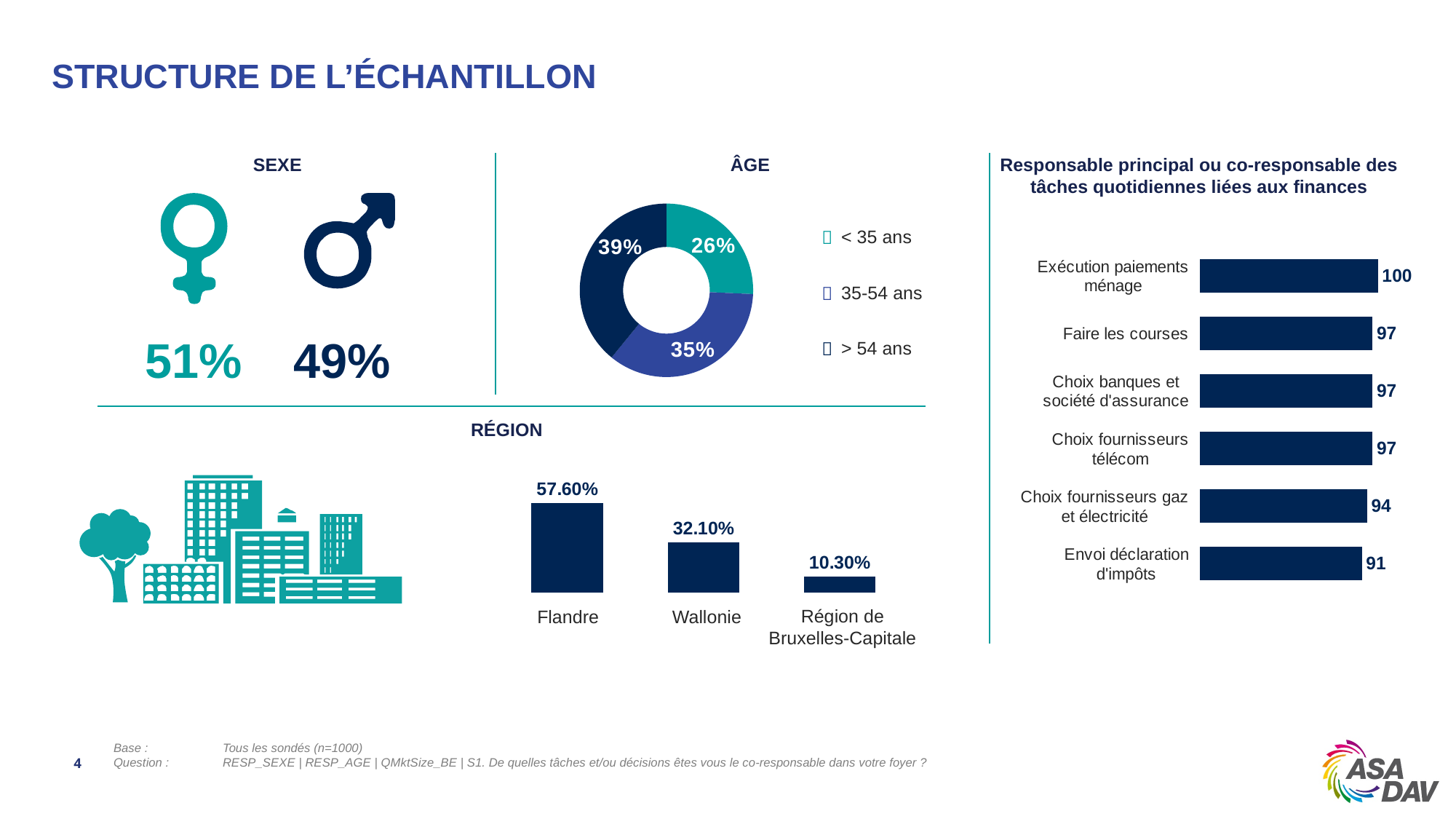
How many regions are shown in the RÉGION chart? 3 What kind of chart is the ÂGE chart? Donut chart In the 'Responsable principal ou co-responsable des tâches quotidiennes liées aux finances' chart, how many tasks are listed? 6 In the RÉGION chart, which region has the highest value? Flandre In the RÉGION chart, what is the difference between Flandre and Région de Bruxelles-Capitale? 47.30% In the ÂGE chart, which age group has the largest share? > 54 ans In the 'Responsable principal ou co-responsable des tâches quotidiennes liées aux finances' chart, which task has the highest value? Exécution paiements ménage In the ÂGE chart, which age group has the smallest share? < 35 ans In the ÂGE chart, what share of respondents are aged 35-54 ans? 35% In the RÉGION chart, what is the value for Wallonie? 32.10% In the 'Responsable principal ou co-responsable des tâches quotidiennes liées aux finances' chart, what is the value for Envoi déclaration d'impôts? 91 In the 'Responsable principal ou co-responsable des tâches quotidiennes liées aux finances' chart, which is larger: Choix fournisseurs gaz et électricité or Envoi déclaration d'impôts? Choix fournisseurs gaz et électricité